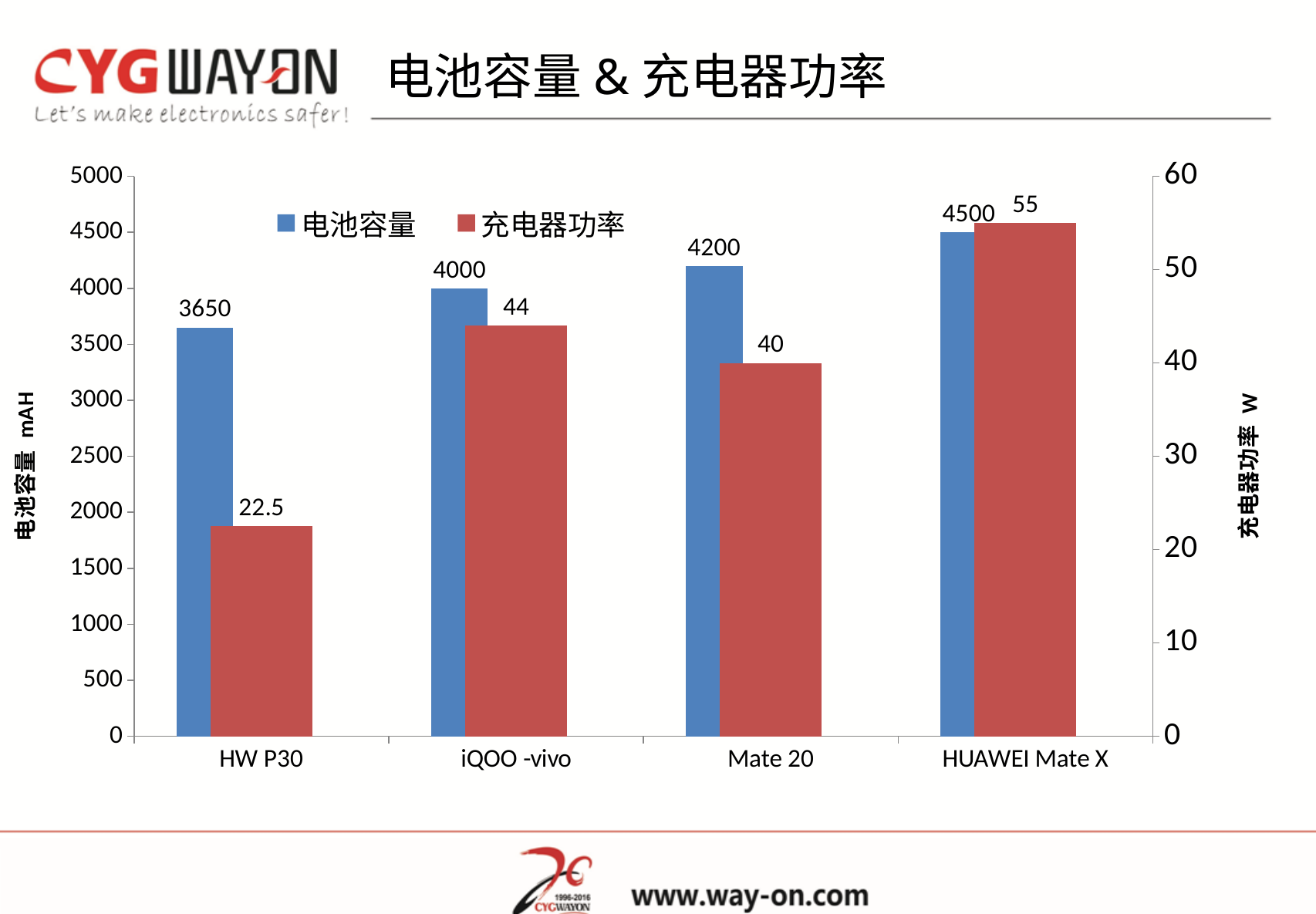
How many series does the legend list? 2 What is the charger power (充电器功率) for HUAWEI Mate X? 55 Which phone has the lowest charger power (充电器功率)? HW P30 What is the difference in charger power (充电器功率) between HUAWEI Mate X and Mate 20? 15 Which phone has the highest battery capacity (电池容量)? HUAWEI Mate X What kind of chart is shown on the slide? bar chart Which has a higher charger power (充电器功率), iQOO -vivo or Mate 20? iQOO -vivo What is the battery capacity (电池容量) for HW P30? 3650 What is the difference in battery capacity (电池容量) between Mate 20 and HW P30? 550 Does the battery capacity (电池容量) rise or fall from HW P30 to HUAWEI Mate X along the x axis? rise What is the charger power (充电器功率) for iQOO -vivo? 44 How many phones are shown on the x axis? 4